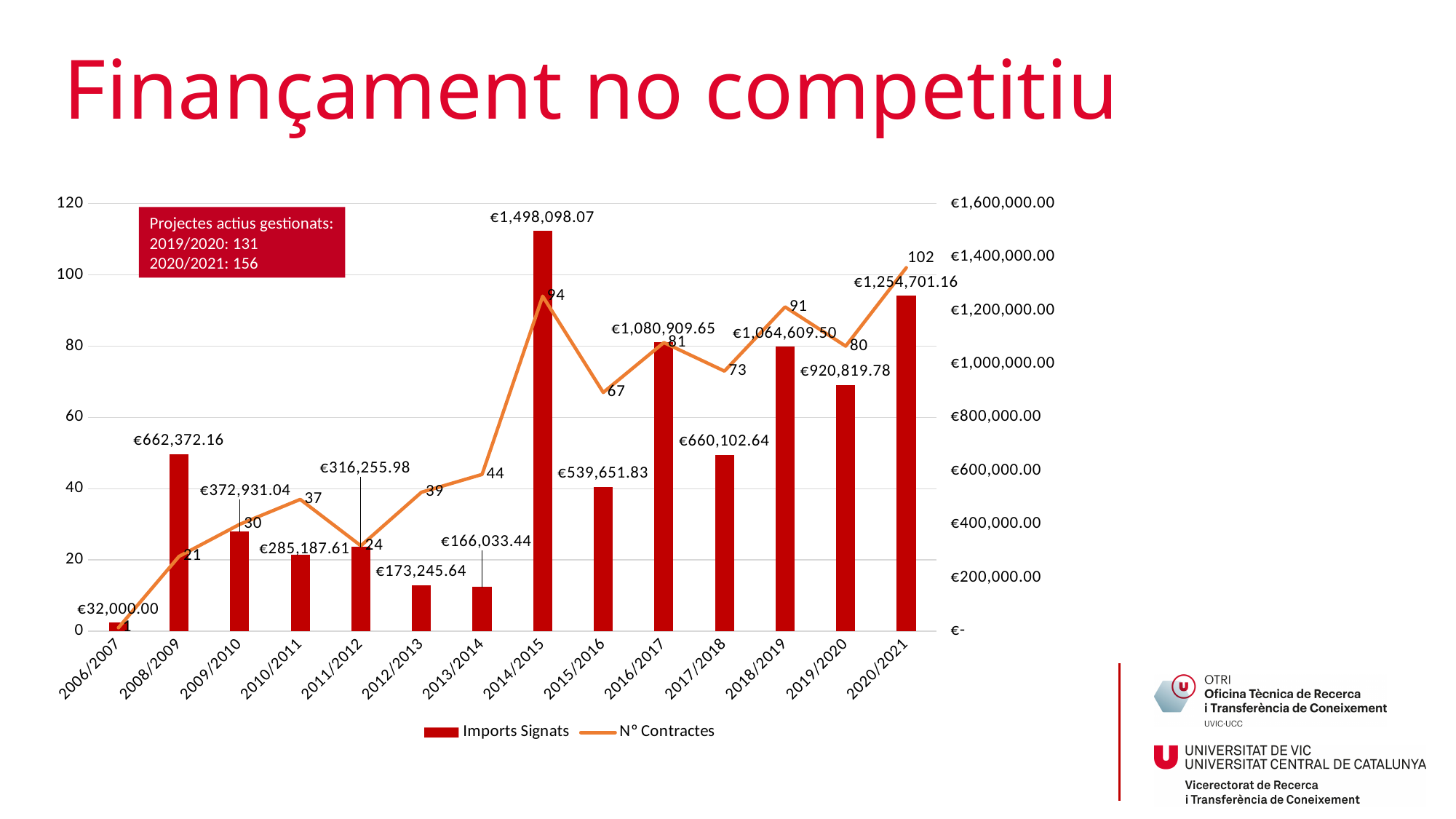
Which academic year has the highest Imports Signats? 2014/2015 What is the value of Imports Signats for 2014/2015? €1,498,098.07 How many contracts (Nº Contractes) are shown for 2020/2021? 102 What type of chart is used to show Imports Signats? bar chart What is the difference in Nº Contractes between 2020/2021 and 2019/2020? 22 How many academic years are shown on the x axis? 14 What is the difference in Imports Signats between 2014/2015 and 2020/2021? €243,396.91 Which academic year has the lowest Nº Contractes? 2006/2007 What is the value of Imports Signats for 2012/2013? €173,245.64 Does the Nº Contractes line rise or fall from 2014/2015 to 2015/2016? fall Which year has a larger Imports Signats value, 2016/2017 or 2018/2019? 2016/2017 How many series does the legend list? 2